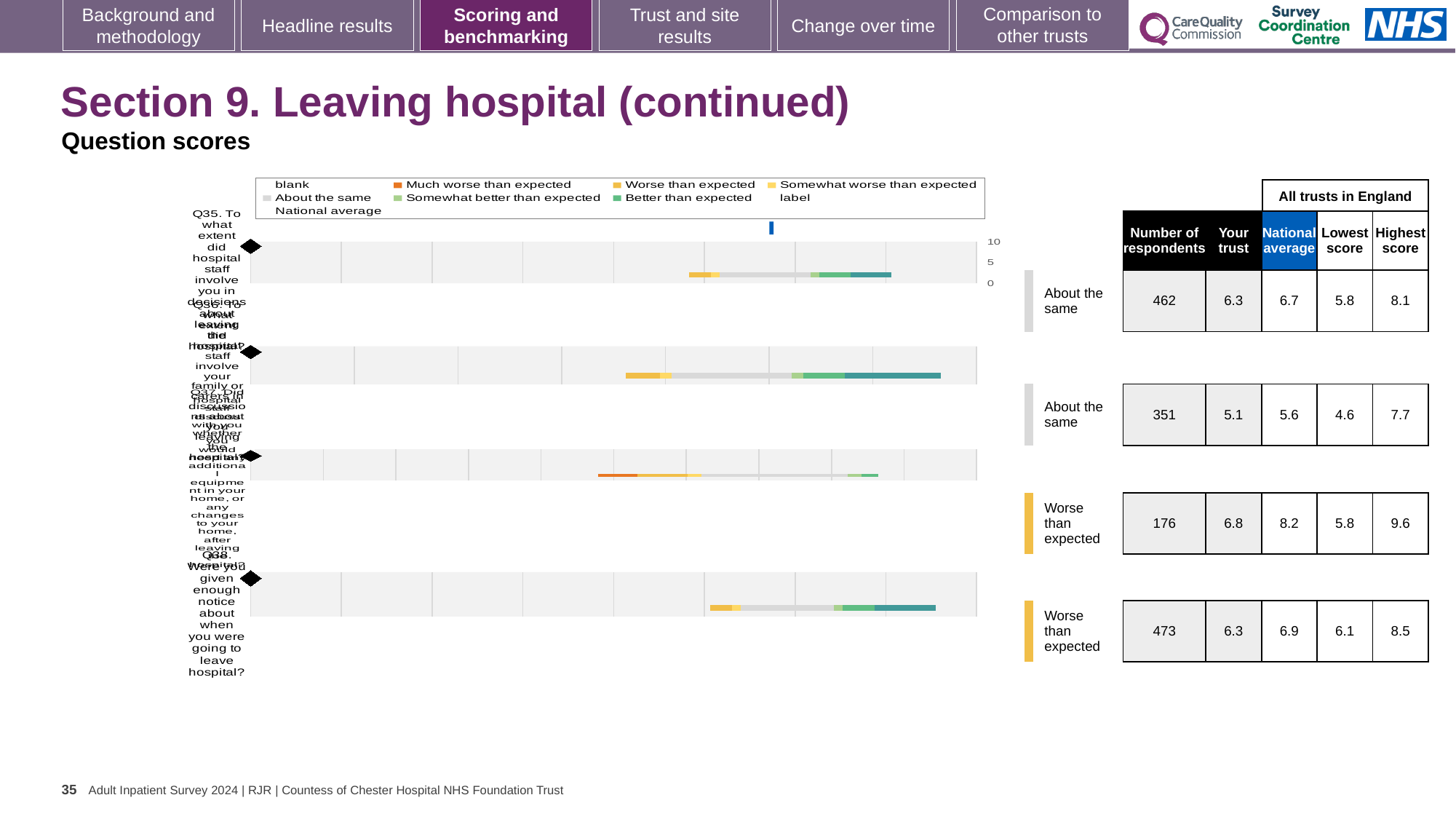
Which row in the table has the highest number of respondents? the fourth row (473) What benchmark category is shown for the fourth row (Q38)? Worse than expected In the table next to the chart, what is the national average for the second row? 5.6 Which is larger in the first row of the table: the 'Your trust' score or the national average? national average In the table next to the chart, what is the highest score for the third row? 9.6 How many question bars are plotted in the chart? 4 What kind of chart is used to show the question scores on this slide? bar chart In the table next to the chart, what is the number of respondents for the first row (Q35)? 462 Which row in the table has the lowest number of respondents? the third row (176) What is the difference between the national average and the 'Your trust' score in the third row of the table? 1.4 In the table next to the chart, what is the 'Your trust' score for the first row (Q35)? 6.3 In the table next to the chart, what is the lowest score for the fourth row (Q38)? 6.1